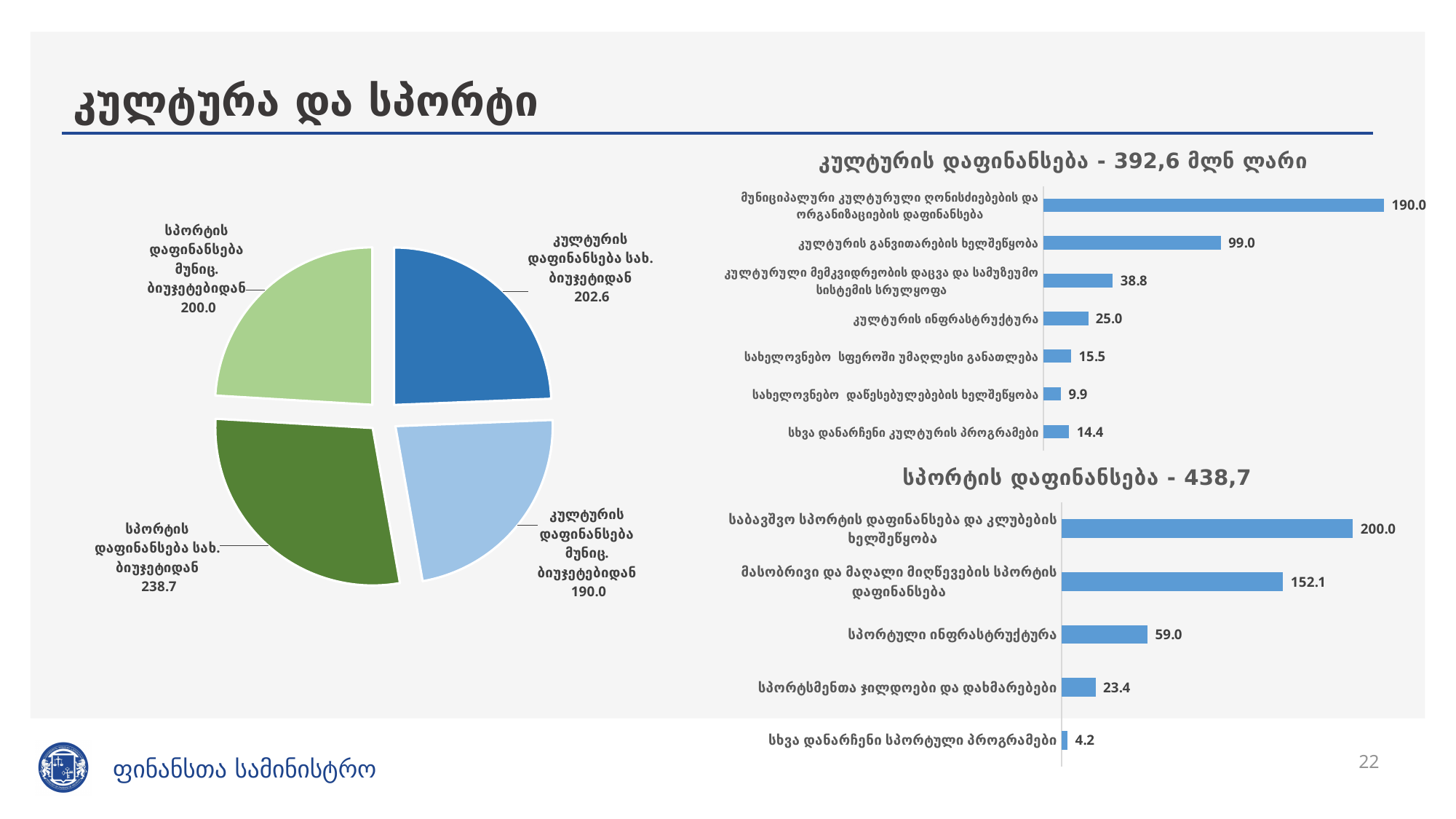
In the bar chart titled 'კულტურის დაფინანსება - 392,6 მლნ ლარი', which category has the lowest value? სახელოვნებო დაწესებულებების ხელშეწყობა In the bar chart titled 'სპორტის დაფინანსება - 438,7', how many categories are shown? 5 In the bar chart titled 'კულტურის დაფინანსება - 392,6 მლნ ლარი', what is the difference between 'კულტურის ინფრასტრუქტურა' and 'სახელოვნებო სფეროში უმაღლესი განათლება'? 9.5 In the bar chart titled 'სპორტის დაფინანსება - 438,7', what is the value for 'სპორტული ინფრასტრუქტურა'? 59.0 In the bar chart titled 'კულტურის დაფინანსება - 392,6 მლნ ლარი', what is the value for 'კულტურის განვითარების ხელშეწყობა'? 99.0 In the bar chart titled 'კულტურის დაფინანსება - 392,6 მლნ ლარი', which category has the highest value? მუნიციპალური კულტურული ღონისძიებების და ორგანიზაციების დაფინანსება In the bar chart titled 'სპორტის დაფინანსება - 438,7', what is the difference between 'საბავშვო სპორტის დაფინანსება და კლუბების ხელშეწყობა' and 'მასობრივი და მაღალი მიღწევების სპორტის დაფინანსება'? 47.9 In the bar chart titled 'სპორტის დაფინანსება - 438,7', which category has the lowest value? სხვა დანარჩენი სპორტული პროგრამები In the pie chart on the left of the slide, what is the value for 'სპორტის დაფინანსება სახ. ბიუჯეტიდან'? 238.7 What kind of chart is shown on the left of the slide? Pie chart In the pie chart on the left of the slide, which slice is larger: 'კულტურის დაფინანსება სახ. ბიუჯეტიდან' or 'კულტურის დაფინანსება მუნიც. ბიუჯეტებიდან'? კულტურის დაფინანსება სახ. ბიუჯეტიდან In the bar chart titled 'კულტურის დაფინანსება - 392,6 მლნ ლარი', how many categories are shown? 7